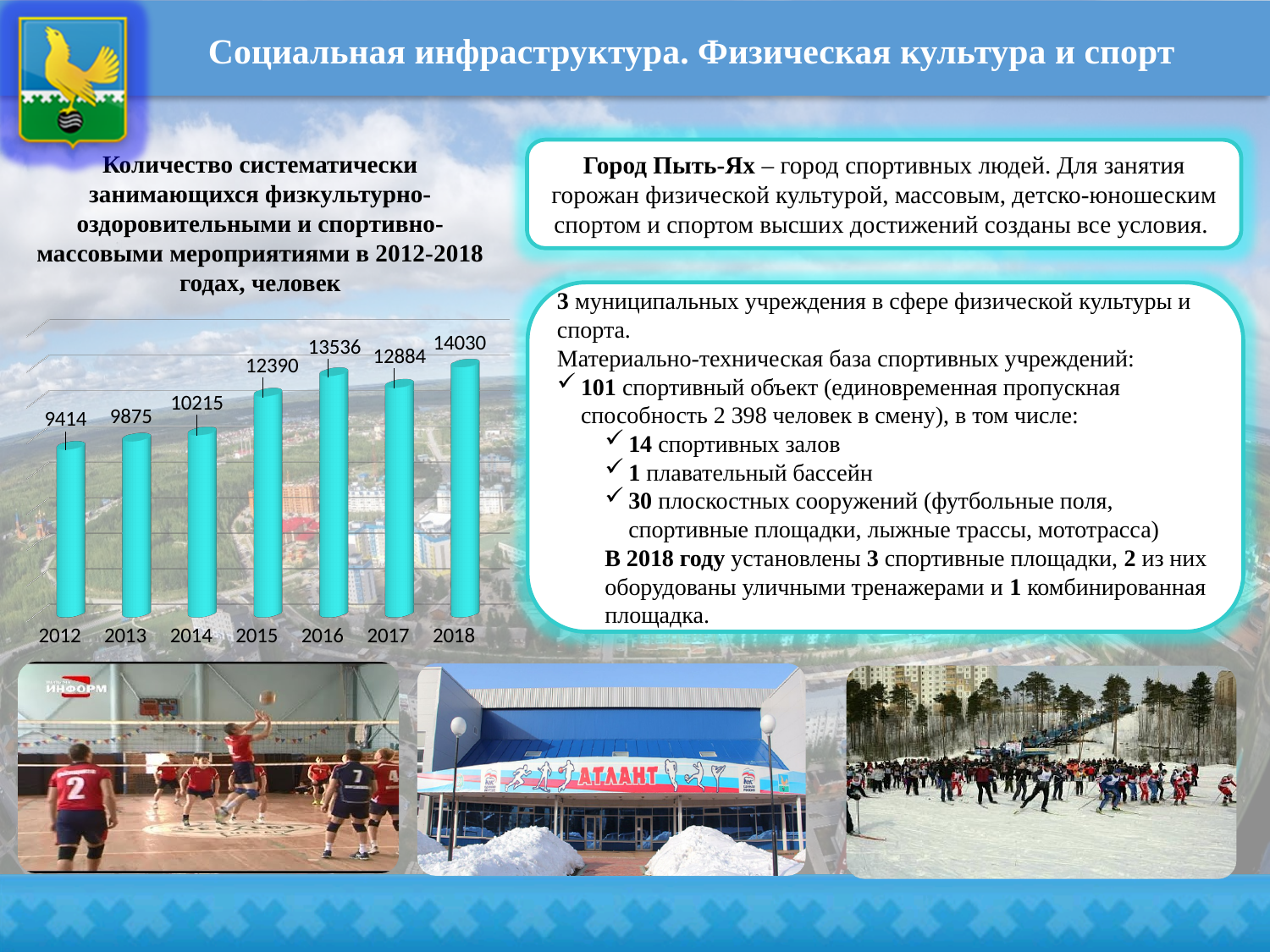
Which year has the highest value in the chart? 2018 Does the value fall or rise from 2016 to 2017? fall How many years are shown in the chart? 7 Which is larger, the value for 2015 or the value for 2017? 2017 What is the value for 2017 in the chart? 12884 What is the value for 2016 in the chart? 13536 What is the difference between the values for 2018 and 2012? 4616 What kind of chart is shown on the slide? bar chart What unit of measurement does the chart title state the values are in? человек Which year has the lowest value in the chart? 2012 What is the value for 2012 in the chart? 9414 What is the difference between the values for 2016 and 2017? 652